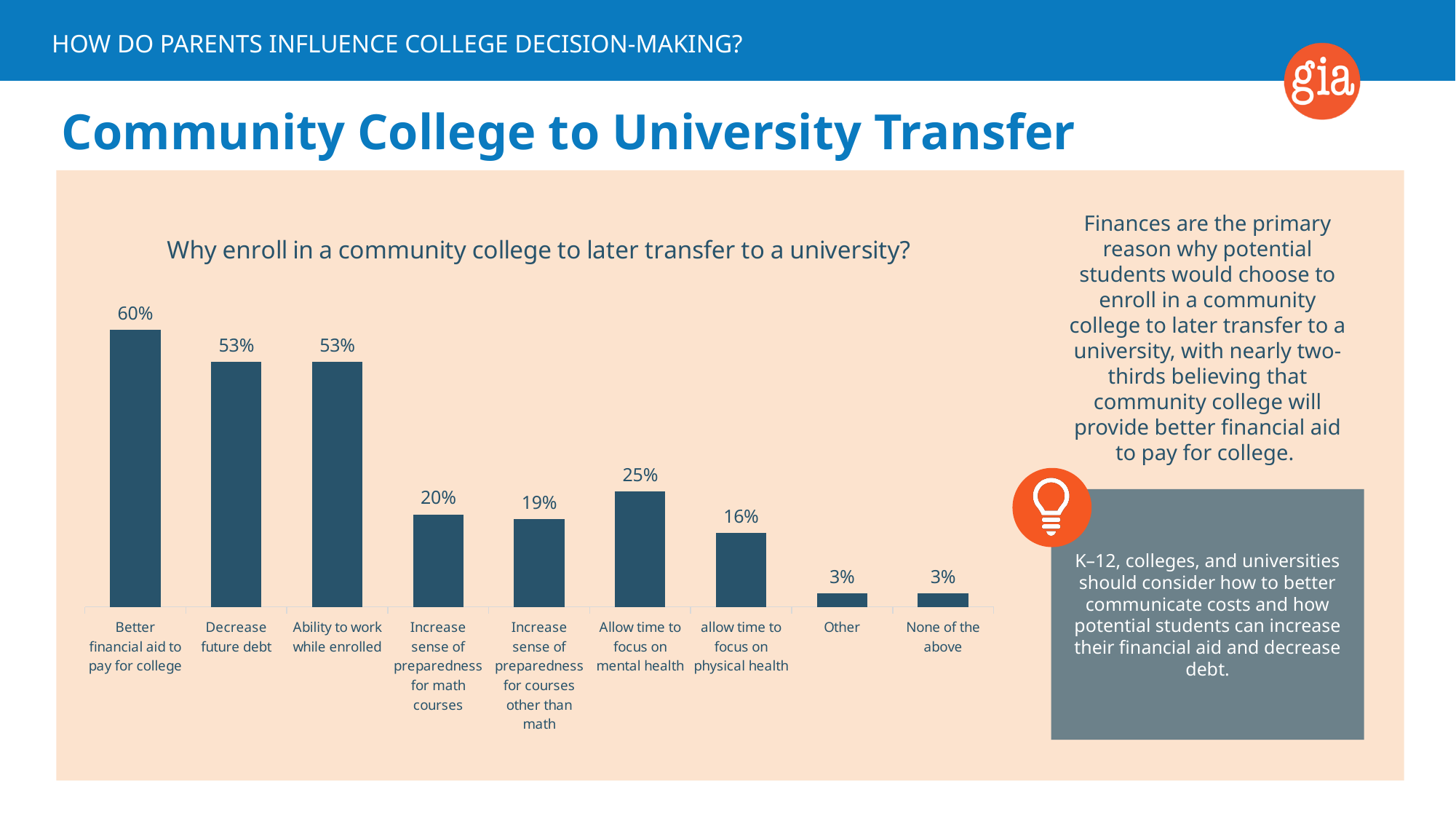
What percentage of respondents chose 'Better financial aid to pay for college' as a reason to enroll in a community college to later transfer to a university? 60% How many categories are shown in the chart? 9 What is the difference between the values for 'Better financial aid to pay for college' and 'Decrease future debt'? 7% What is the value for 'Allow time to focus on mental health'? 25% What kind of chart is shown on the slide? Bar chart Do the values generally rise or fall from left to right across the chart? Fall What is the lowest value shown in the chart? 3% Which is larger: 'Increase sense of preparedness for math courses' or 'Allow time to focus on mental health'? Allow time to focus on mental health What is the value for 'Increase sense of preparedness for courses other than math'? 19% What is the difference between 'Allow time to focus on mental health' and 'allow time to focus on physical health'? 9% What is the title of the chart? Why enroll in a community college to later transfer to a university? Which category has the highest value in the chart? Better financial aid to pay for college